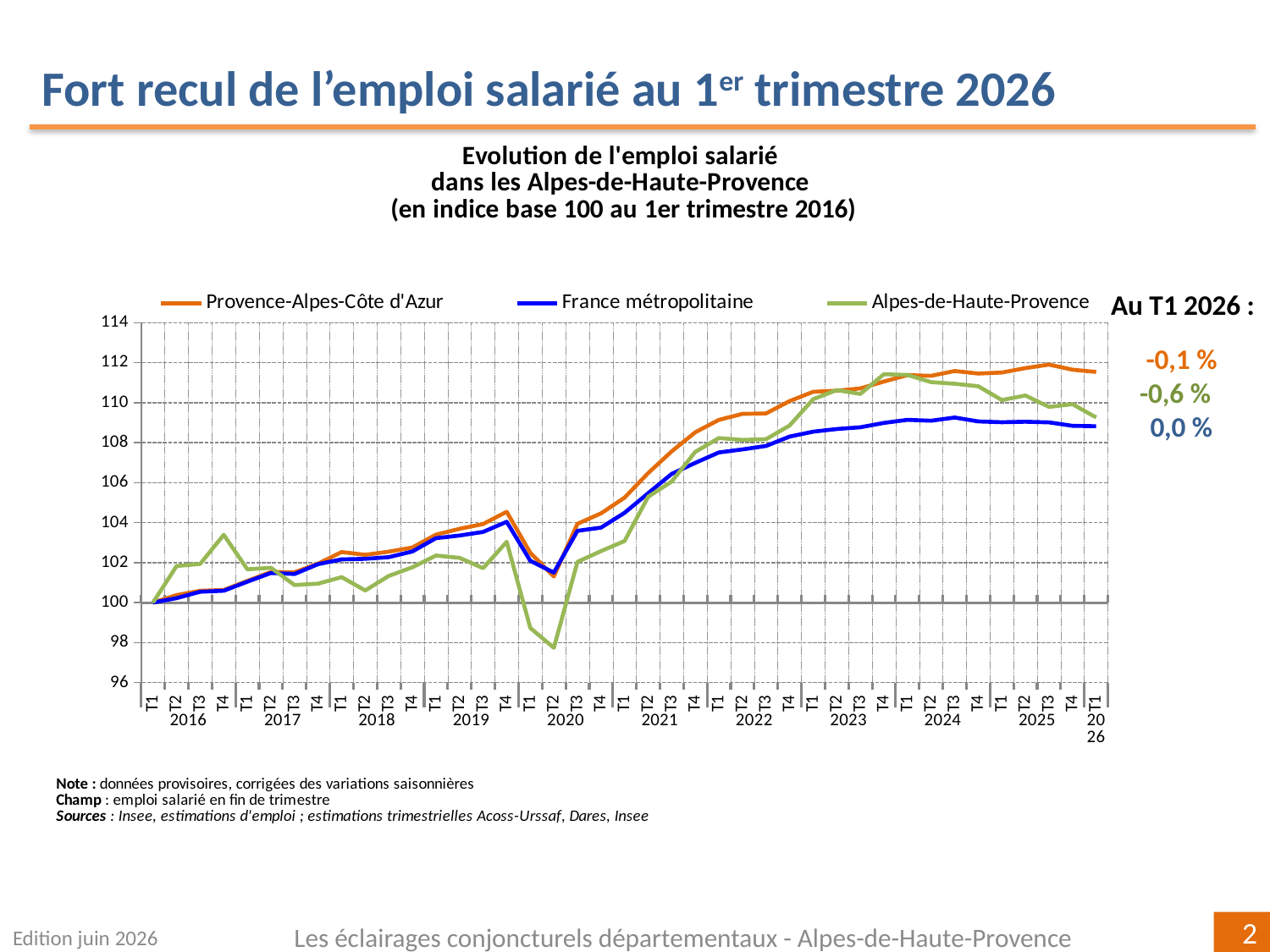
What is the index value of all three series at T1 2016? 100 Is the value for Alpes-de-Haute-Provence at T2 2020 greater or less than 100? less According to the annotation 'Au T1 2026', what is the change shown for Alpes-de-Haute-Provence? -0,6 % Which series has the lowest value at T2 2020? Alpes-de-Haute-Provence What kind of chart is shown on the slide? line chart Is the value for Provence-Alpes-Côte d'Azur at T1 2026 greater or less than 110? greater Which three series are listed in the legend? Provence-Alpes-Côte d'Azur, France métropolitaine, Alpes-de-Haute-Provence Overall, does the France métropolitaine series rise or fall from T1 2016 to T1 2026? rise According to the annotation 'Au T1 2026', what is the change shown for Provence-Alpes-Côte d'Azur? -0,1 % At T4 2016, which is higher: Alpes-de-Haute-Provence or Provence-Alpes-Côte d'Azur? Alpes-de-Haute-Provence Is the value for France métropolitaine at T1 2026 greater or less than 110? less How many series does the legend list? 3